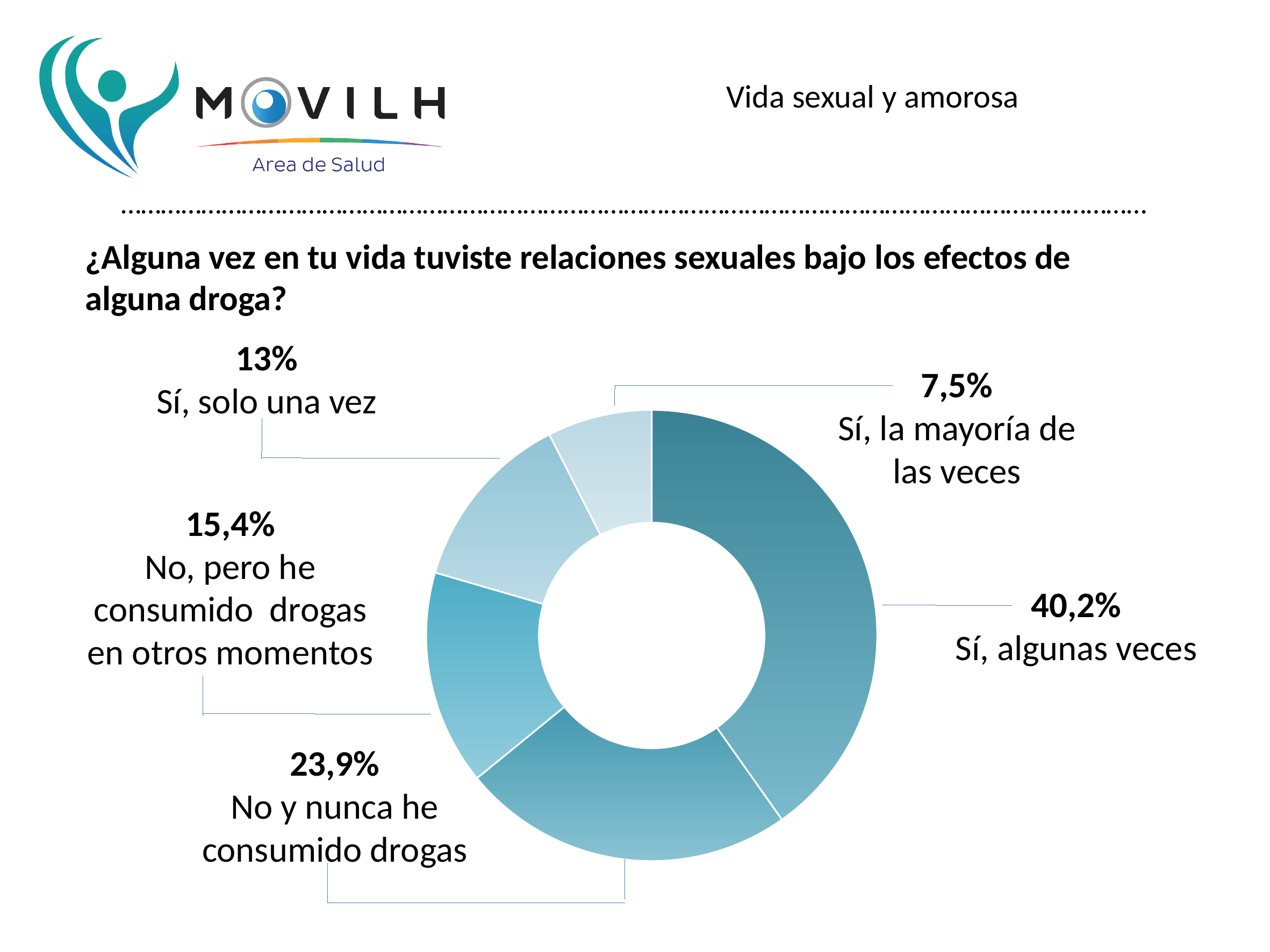
Which response has the smallest share of the chart? Sí, la mayoría de las veces What percentage of respondents answered "No y nunca he consumido drogas"? 23,9% How many response categories are shown in the chart? 5 What percentage of respondents answered "Sí, la mayoría de las veces"? 7,5% Which is larger: the share for "No, pero he consumido drogas en otros momentos" or the share for "Sí, solo una vez"? No, pero he consumido drogas en otros momentos What percentage of respondents answered "Sí, algunas veces"? 40,2% What kind of chart is shown on the slide? Doughnut chart What question does the chart on the slide answer? ¿Alguna vez en tu vida tuviste relaciones sexuales bajo los efectos de alguna droga? What percentage of respondents answered "No, pero he consumido drogas en otros momentos"? 15,4% What percentage of respondents answered "Sí, solo una vez"? 13% What is the difference in percentage points between "Sí, algunas veces" and "No y nunca he consumido drogas"? 16,3 Which response has the largest share of the chart? Sí, algunas veces